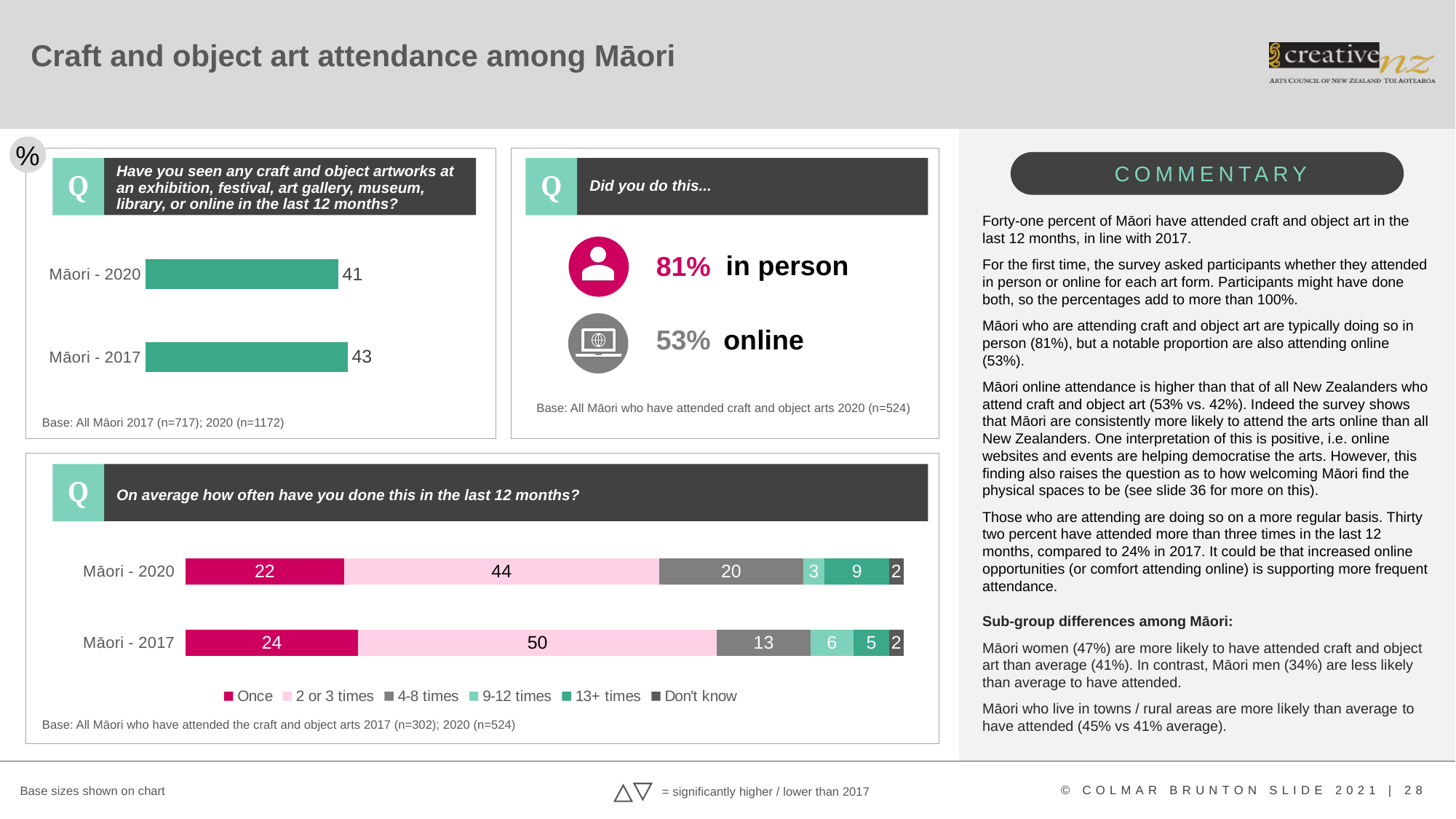
In the bottom stacked bar chart on attendance frequency, what is the value for '2 or 3 times' for Māori - 2020? 44 In the bottom stacked bar chart on attendance frequency, which segment is the largest for Māori - 2017? 2 or 3 times In the bottom stacked bar chart on attendance frequency, what is the total of the Māori - 2020 bar? 100 In the bottom stacked bar chart on attendance frequency, how many series does the legend list? 6 In the top-left chart on craft and object art attendance, which year has the higher value, 2020 or 2017? Māori - 2017 In the bottom stacked bar chart on attendance frequency, what is the value for '4-8 times' for Māori - 2017? 13 What type of chart is the bottom chart on how often Māori have attended in the last 12 months? Stacked bar chart In the top-left chart on craft and object art attendance, what is the difference between the 2017 and 2020 values? 2 In the bottom stacked bar chart on attendance frequency, what is the difference between the 'Once' values for Māori - 2017 and Māori - 2020? 2 In the top-left chart on craft and object art attendance, how many bars are shown? 2 In the top-left chart on craft and object art attendance, what is the value for Māori - 2020? 41 In the top-left chart on craft and object art attendance, what is the value for Māori - 2017? 43